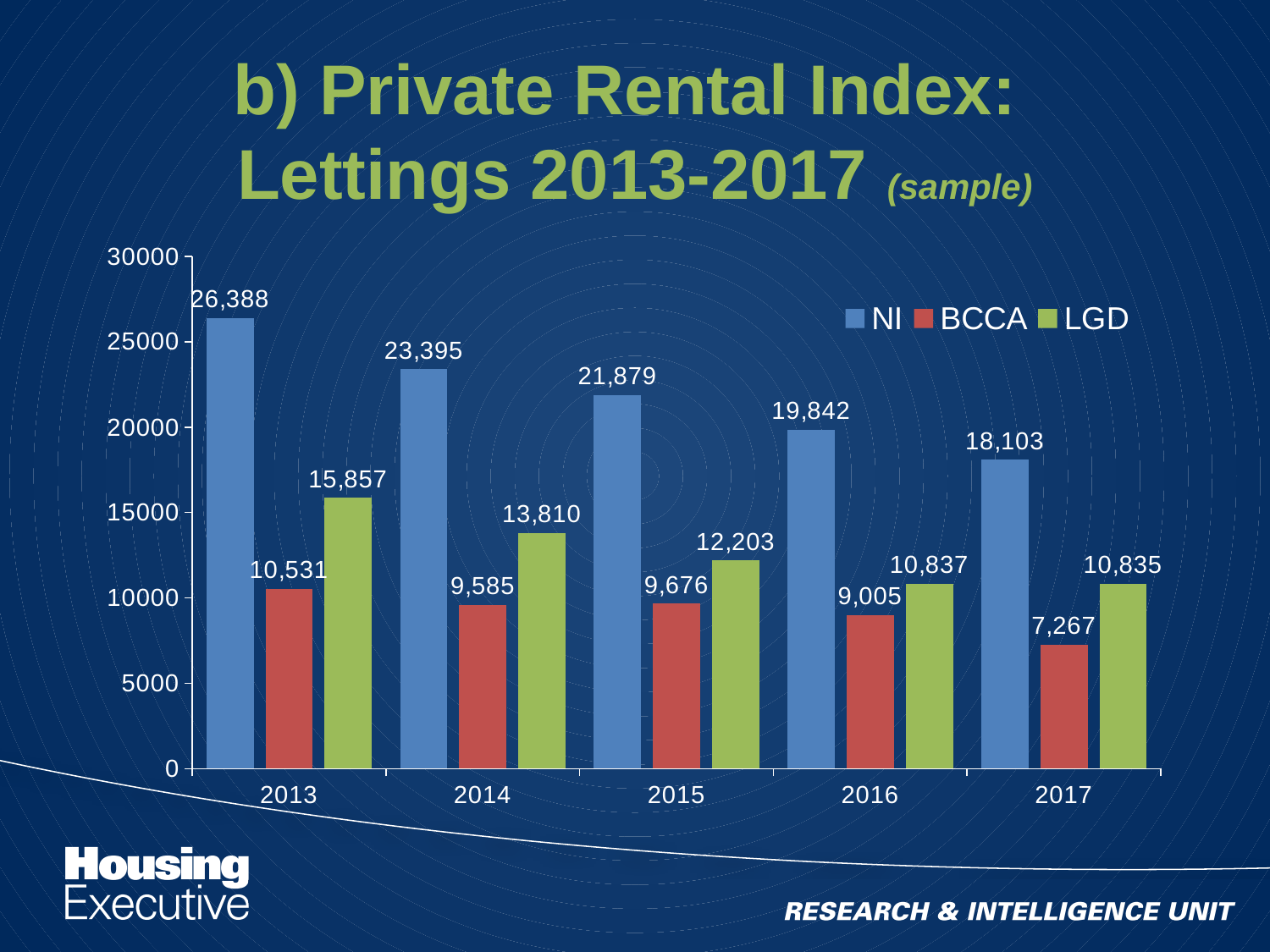
What colour are the BCCA bars? Red What is the difference between the NI values for 2013 and 2017? 8,285 Do the NI values rise or fall from 2013 to 2017? Fall In which year is the BCCA value lowest? 2017 How many series does the legend list? 3 How many years are shown on the x axis? 5 What is the NI value for 2013? 26,388 What is the BCCA value for 2017? 7,267 What is the LGD value for 2015? 12,203 What kind of chart is shown on the slide? Bar chart In which year is the NI value highest? 2013 Which is larger, the LGD value for 2014 or the LGD value for 2016? LGD value for 2014